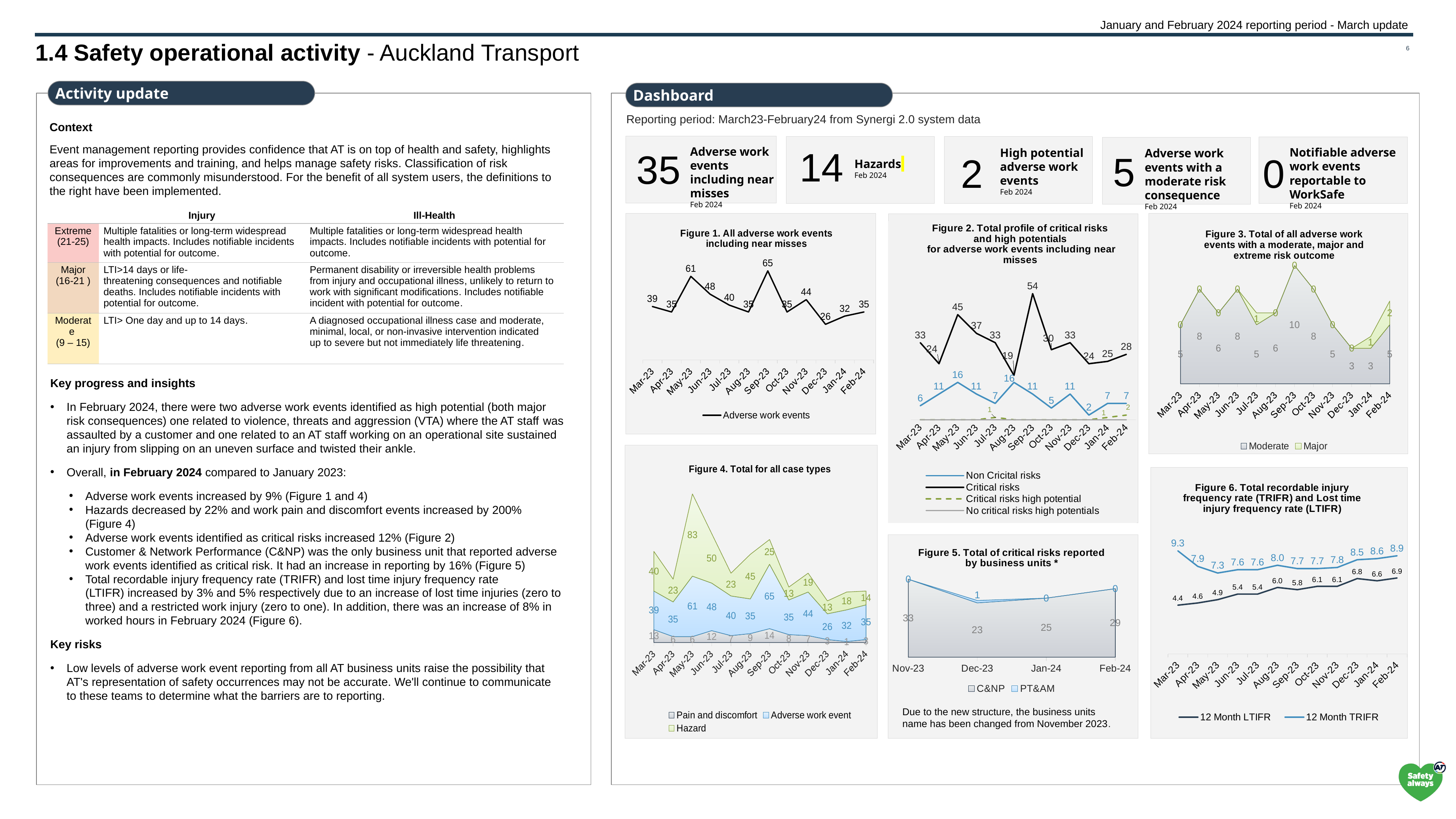
In Figure 6, what kind of chart is used? Line chart In Figure 4 (Total for all case types), what is the Hazard value for May-23? 83 In Figure 6, which is larger for Feb-24: 12 Month LTIFR or 12 Month TRIFR? 12 Month TRIFR In Figure 5 (Total of critical risks reported by business units), what is the C&NP value for Nov-23? 33 In Figure 2, how many series does the legend list? 4 In Figure 2, what is the difference between the Critical risks value and the Non Critical risks value for Feb-24? 21 In Figure 1 (All adverse work events including near misses), which month has the lowest value? Dec-23 In Figure 1 (All adverse work events including near misses), how many months are plotted on the x axis? 12 In Figure 3, what is the Major value for Feb-24? 2 In Figure 2, what is the Critical risks value for Sep-23? 54 In Figure 1 (All adverse work events including near misses), what is the value for Sep-23? 65 In Figure 3, what is the Moderate value for Sep-23? 10